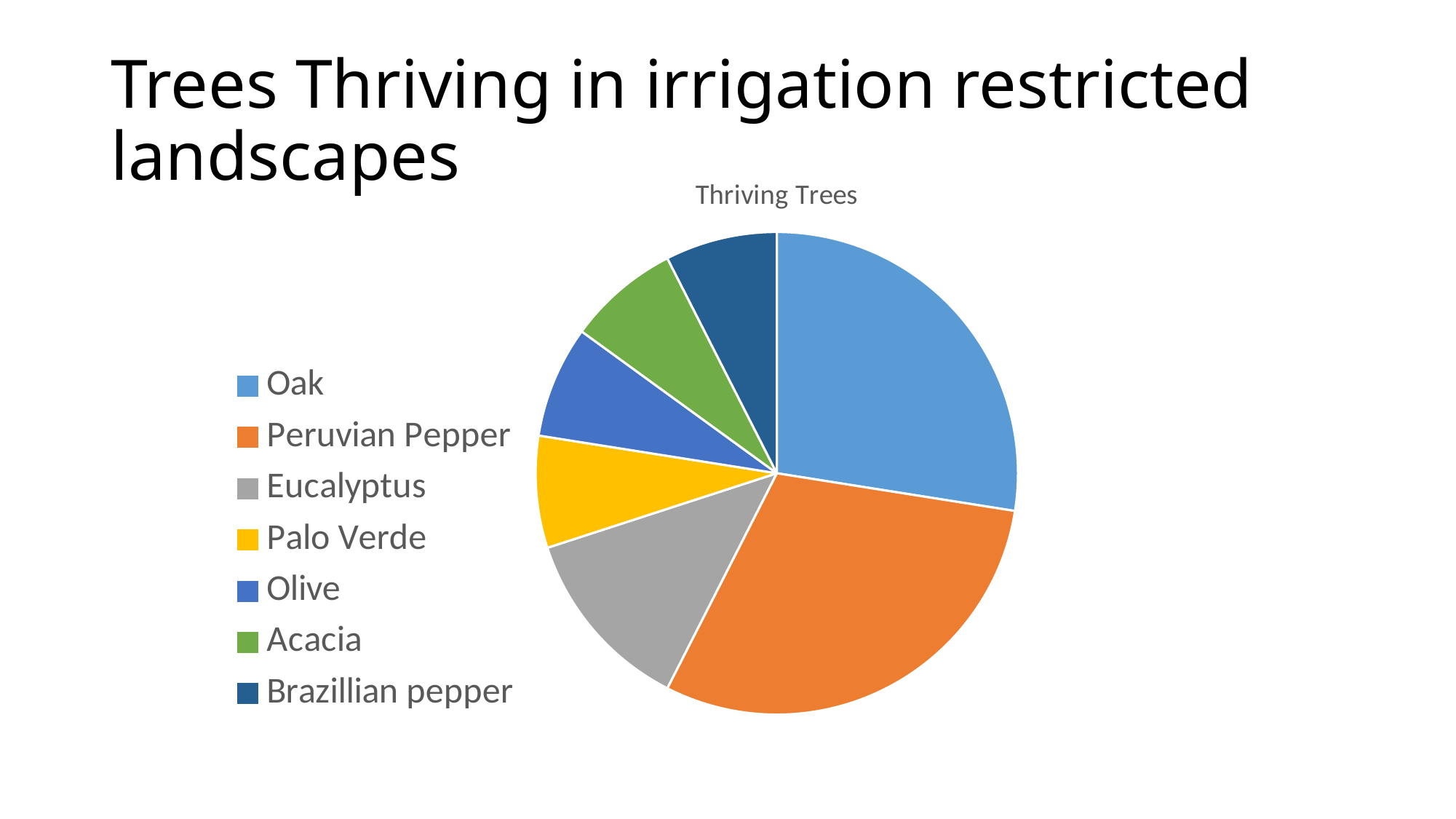
Which slice is larger, Peruvian Pepper or Oak? Peruvian Pepper Which slice is larger, Eucalyptus or Olive? Eucalyptus What kind of chart is shown on the slide? pie chart What colour is the Palo Verde slice in the pie chart? yellow Which slice is larger, Oak or Brazillian pepper? Oak Which tree has the largest slice of the pie chart? Peruvian Pepper How many categories (slices) does the pie chart have? 7 What is the title of the chart? Thriving Trees